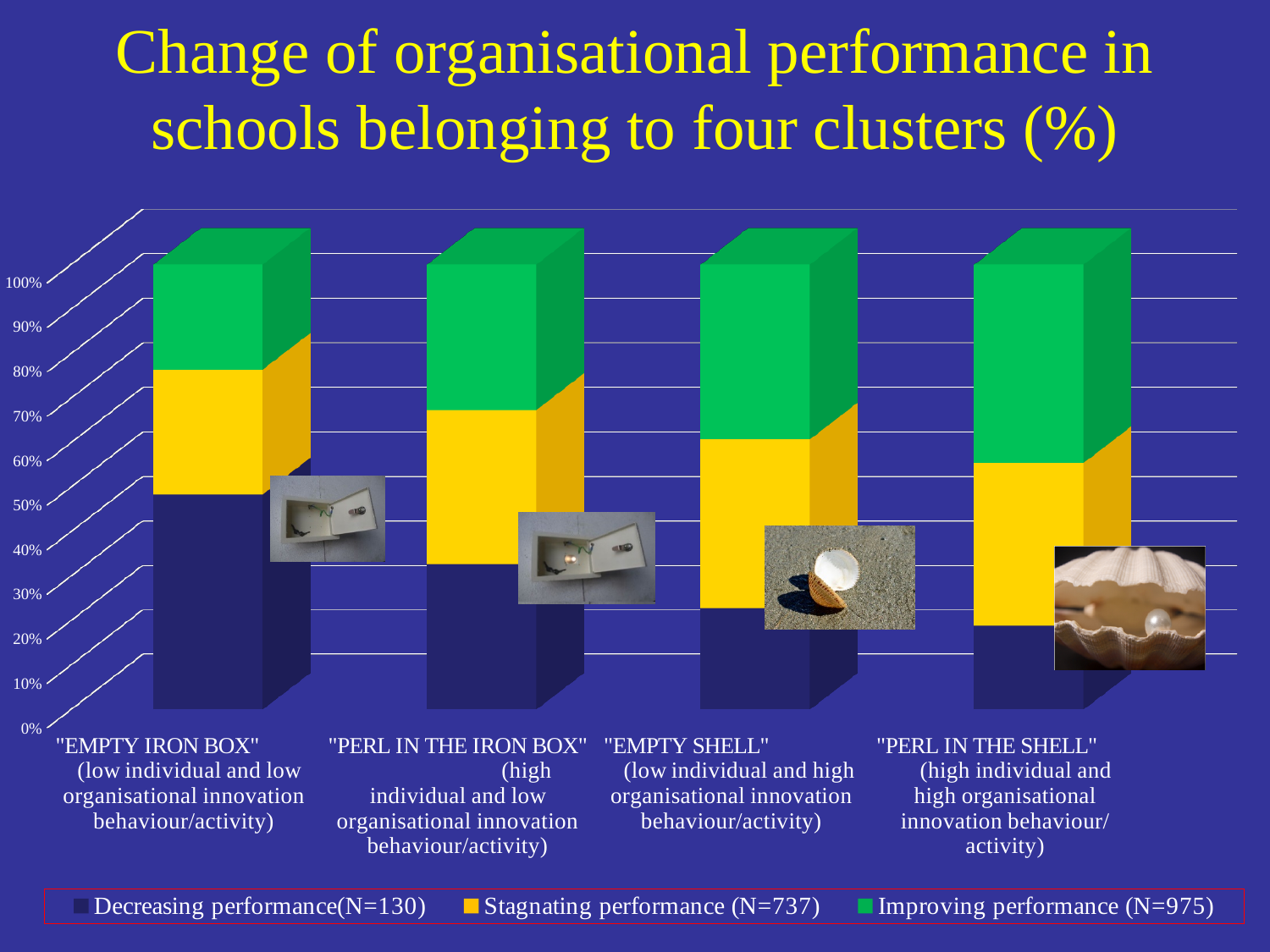
What kind of chart is shown on the slide? Stacked bar chart Is the Improving performance share in the "PERL IN THE SHELL" cluster greater or less than 30%? greater Does the Decreasing performance share rise or fall across the clusters from left to right? fall Which is larger: the Decreasing performance share in "EMPTY IRON BOX" or in "EMPTY SHELL"? "EMPTY IRON BOX" How many series does the chart's legend list? 3 Is the value for Decreasing performance in the "EMPTY IRON BOX" cluster greater or less than 40%? greater According to the legend, what is the N for Decreasing performance? N=130 How many clusters (categories) are shown on the x axis of the chart? 4 Which cluster has the largest share of Decreasing performance? "EMPTY IRON BOX" Is the value for Decreasing performance in the "PERL IN THE SHELL" cluster greater or less than 30%? less Which cluster has the smallest share of Decreasing performance? "PERL IN THE SHELL"